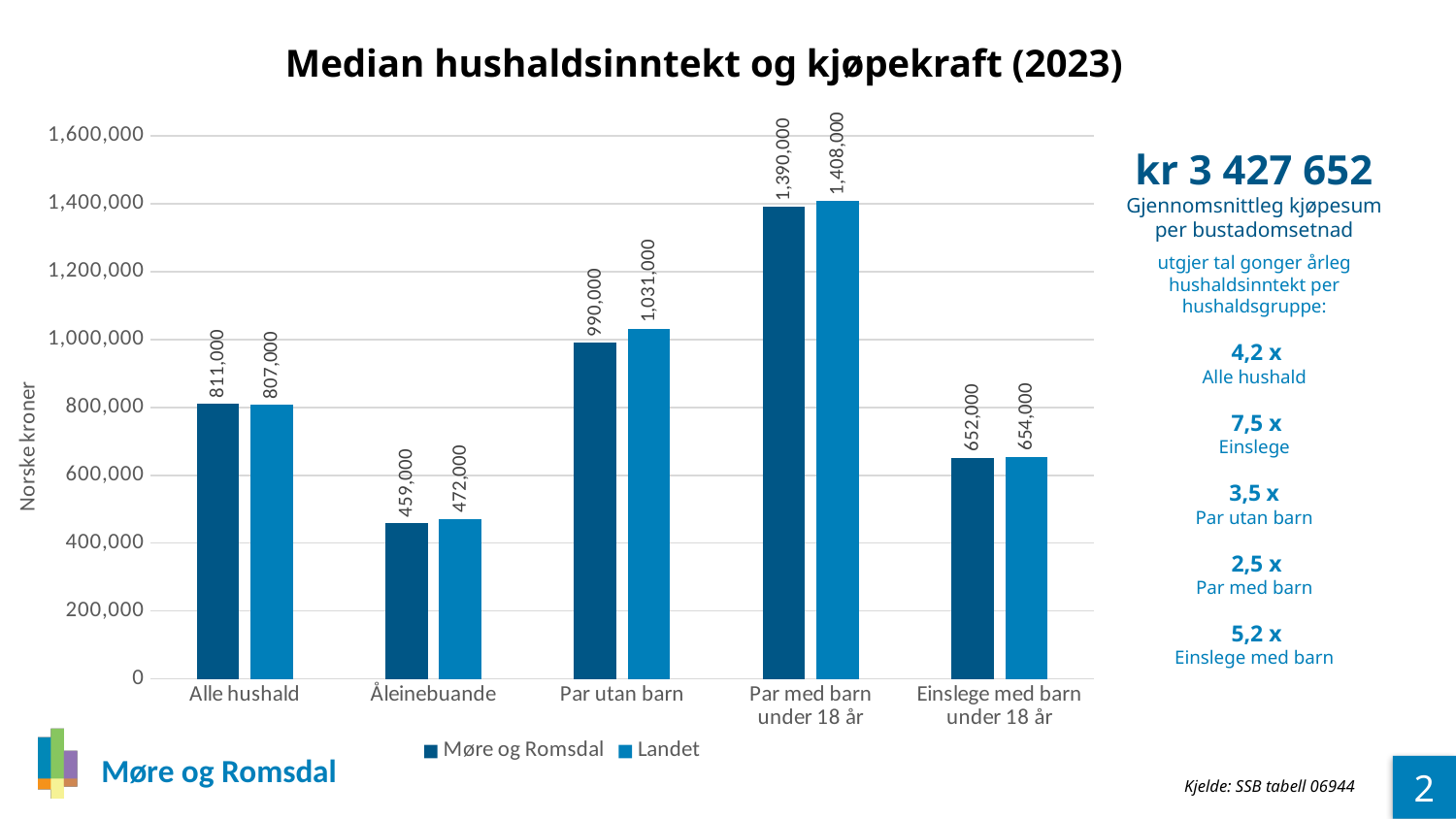
Which is larger in the Par utan barn category, Møre og Romsdal or Landet? Landet Which category has the highest value for Landet? Par med barn under 18 år How many categories are shown on the x axis? 5 What is the title of the chart? Median hushaldsinntekt og kjøpekraft (2023) What is the value for Landet in the Einslege med barn under 18 år category? 654,000 What is the value for Møre og Romsdal in the Åleinebuande category? 459,000 What is the value for Møre og Romsdal in the Alle hushald category? 811,000 Which category has the lowest value for Møre og Romsdal? Åleinebuande What is the value for Landet in the Par utan barn category? 1,031,000 How many series does the legend list? 2 What kind of chart is shown on the slide? Bar chart What is the difference between Landet and Møre og Romsdal in the Par med barn under 18 år category? 18,000